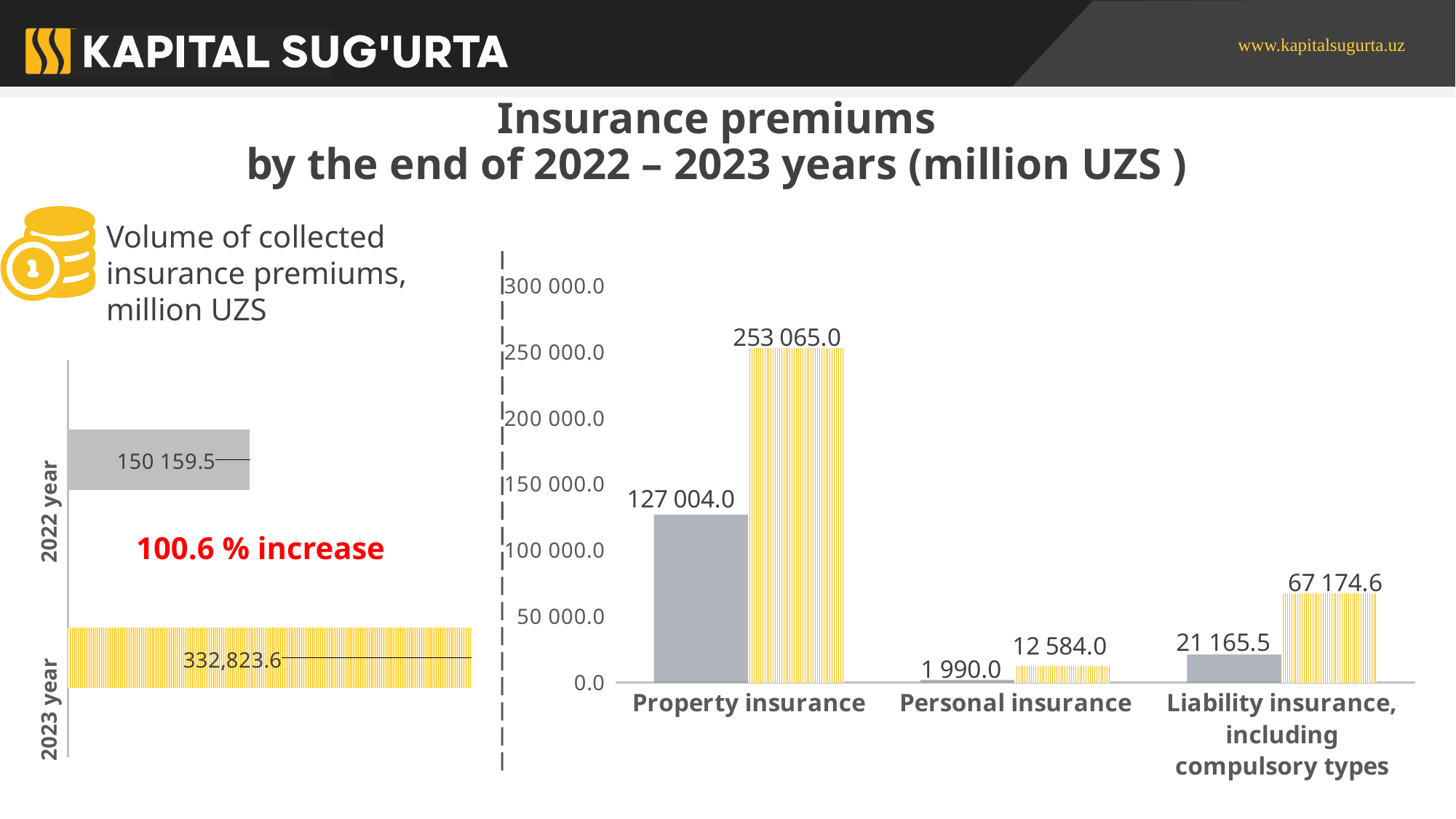
In the right chart, what is the value of the grey bar for Liability insurance, including compulsory types? 21 165.5 In the right chart, how many categories are shown on the x axis? 3 In the left chart (Volume of collected insurance premiums), what is the value for 2022 year? 150 159.5 In the left chart (Volume of collected insurance premiums), what is the value for 2023 year? 332,823.6 What kind of chart is the left chart (Volume of collected insurance premiums)? bar chart In the right chart, is the yellow bar for Liability insurance, including compulsory types greater or less than 50 000.0? greater In the right chart, which category has the lowest grey bar? Personal insurance In the right chart, what is the value of the yellow bar for Property insurance? 253 065.0 In the right chart, what is the value of the grey bar for Property insurance? 127 004.0 In the left chart (Volume of collected insurance premiums), which year has the higher value? 2023 year In the left chart (Volume of collected insurance premiums), what percentage increase is stated between 2022 and 2023? 100.6 % increase In the right chart, what is the value of the yellow bar for Personal insurance? 12 584.0